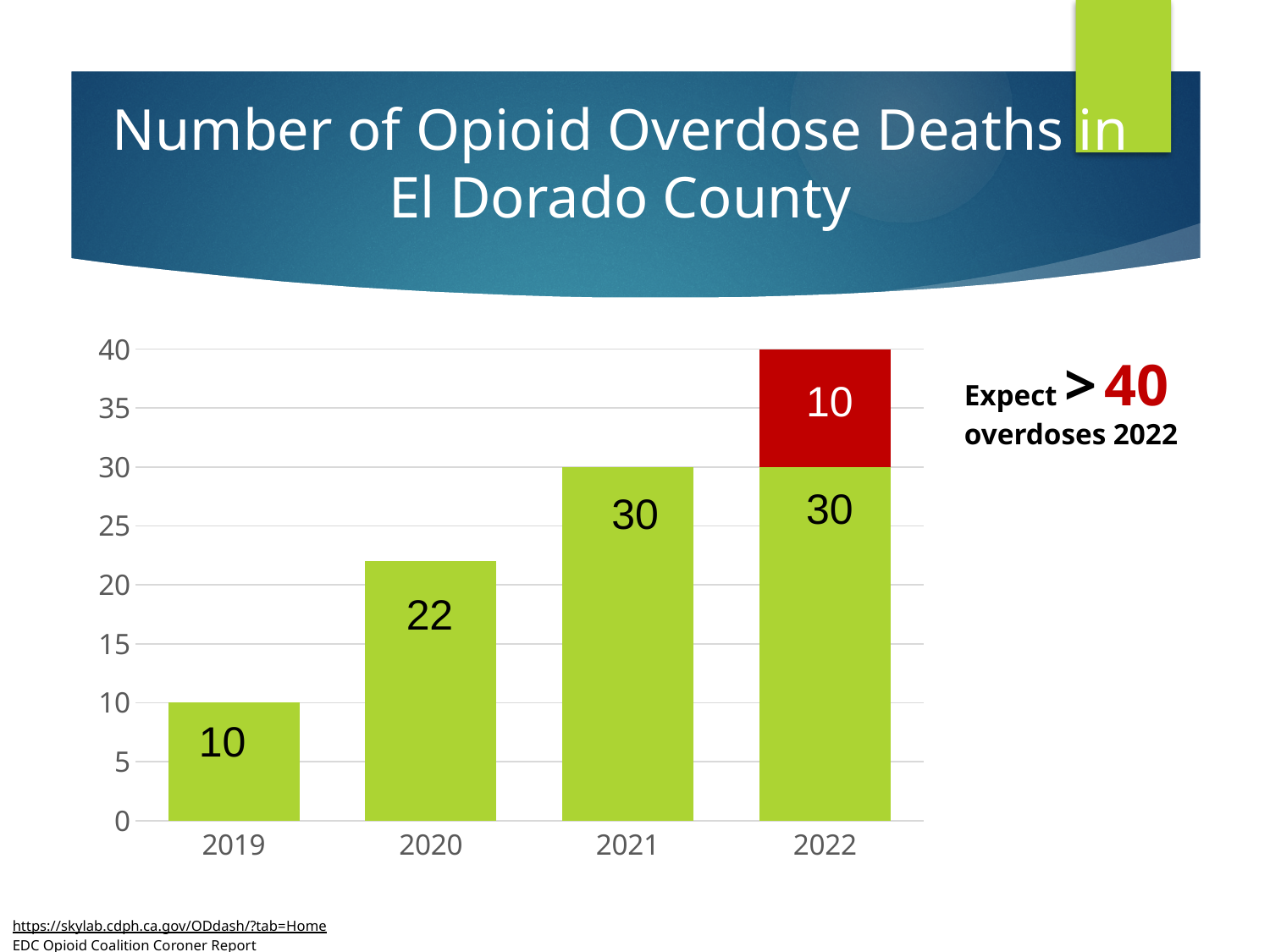
Which is larger, the green bar value for 2020 or for 2019? 2020 Which year has the tallest bar overall? 2022 What is the difference between the green bar values for 2021 and 2020? 8 What is the value of the green bar for 2021? 30 Which year has the lowest green bar value? 2019 Do the bar values rise or fall from 2019 to 2022? rise What kind of chart is shown on the slide? bar chart What is the value of the green bar for 2020? 22 What is the total height of the stacked bar for 2022? 40 What is the value of the red segment on the 2022 bar? 10 How many years are shown on the x axis? 4 What is the value of the green bar for 2019? 10